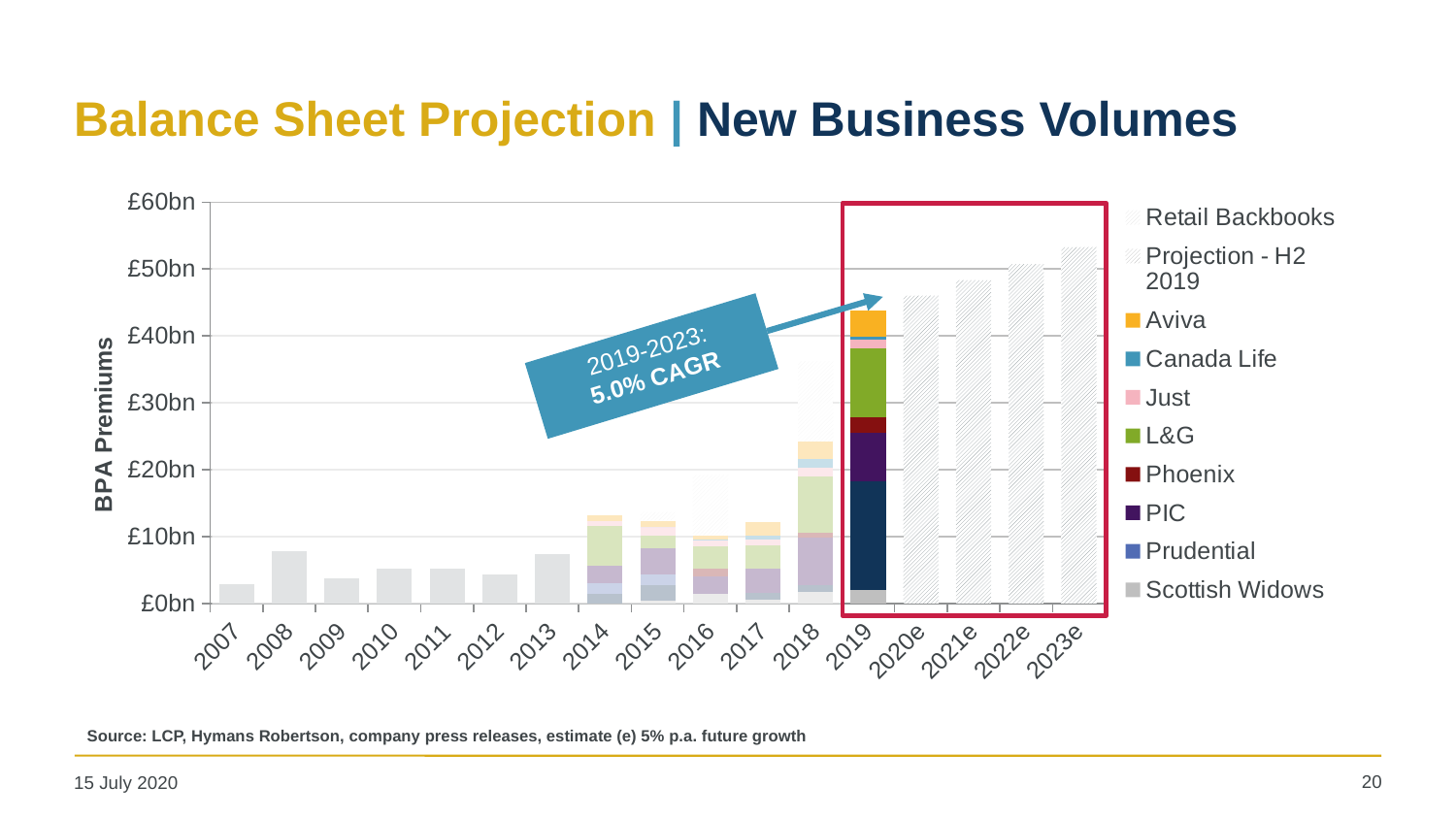
What kind of chart is shown on the slide? Stacked bar chart Is the total value for 2023e greater or less than £50bn? greater Which year has the larger total, 2017 or 2018? 2018 Do the projected totals rise or fall from 2019 to 2023e? Rise Is the total value for 2008 greater or less than £10bn? less How many series does the legend list? 10 Which year has the lowest total BPA premiums? 2007 Which year has the highest total BPA premiums? 2023e Is the total value for 2020e greater or less than £50bn? less How many year categories are shown on the x axis? 17 What CAGR for 2019-2023 is stated in the annotation on the chart? 5.0% CAGR